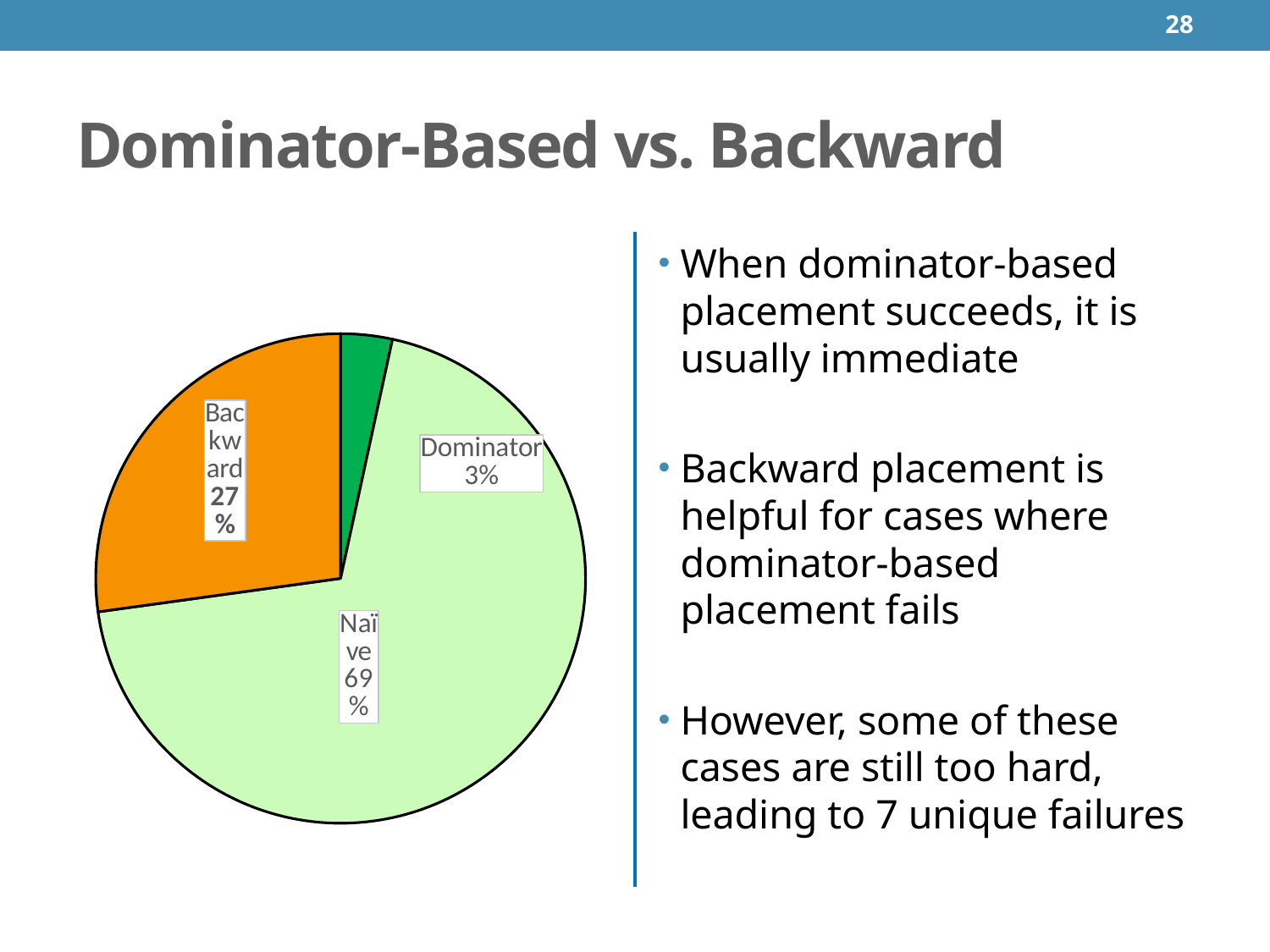
How many slices does the pie chart have? 3 What colour is the Backward slice in the pie chart? orange Which slice of the pie chart is the largest? Naïve What is the difference in percentage points between the Backward and Dominator slices? 24 What percentage does the Dominator slice represent? 3% What percentage does the Backward slice represent? 27% Which slice of the pie chart is the smallest? Dominator What is the difference in percentage points between the Naïve and Backward slices? 42 What percentage does the Naïve slice represent? 69% Which is larger, the Backward slice or the Dominator slice? Backward What kind of chart is shown on the slide? pie chart What share of the pie does the Backward slice take? 27%